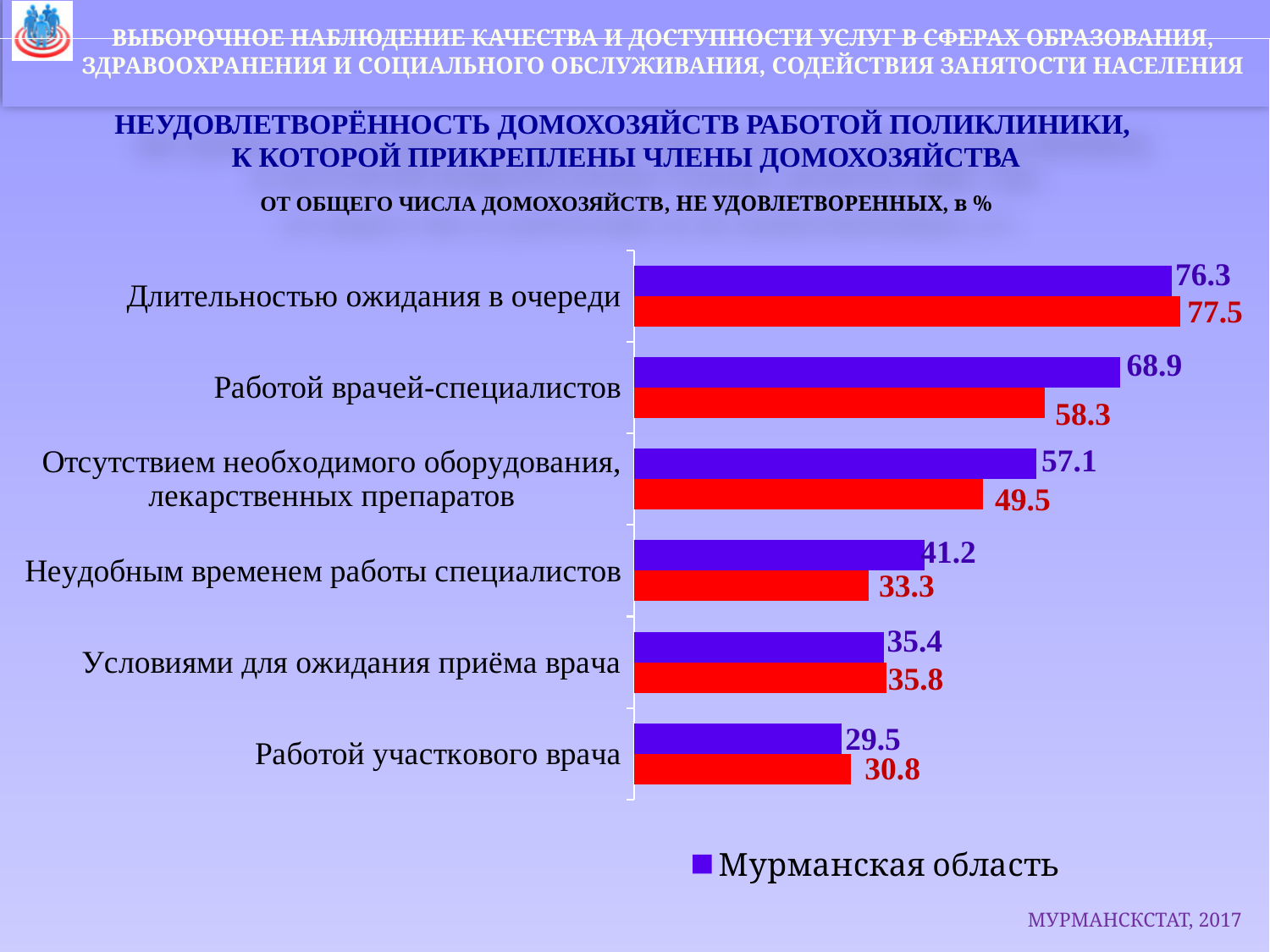
How many categories are shown on the chart? 6 Which category has the lowest value for Мурманская область? Работой участкового врача What is the value of the red bar for "Работой врачей-специалистов"? 58.3 For "Неудобным временем работы специалистов", which is larger: the Мурманская область bar or the red bar? Мурманская область What is the value of the red bar for "Работой участкового врача"? 30.8 Which category has the highest value for Мурманская область? Длительностью ожидания в очереди What is the value for Мурманская область for "Неудобным временем работы специалистов"? 41.2 What is the value for Мурманская область for "Длительностью ожидания в очереди"? 76.3 What is the difference between the Мурманская область value and the red bar value for "Работой врачей-специалистов"? 10.6 What is the difference between the Мурманская область value and the red bar value for "Отсутствием необходимого оборудования, лекарственных препаратов"? 7.6 What kind of chart is shown on the slide? Bar chart How many series does the legend list? 1